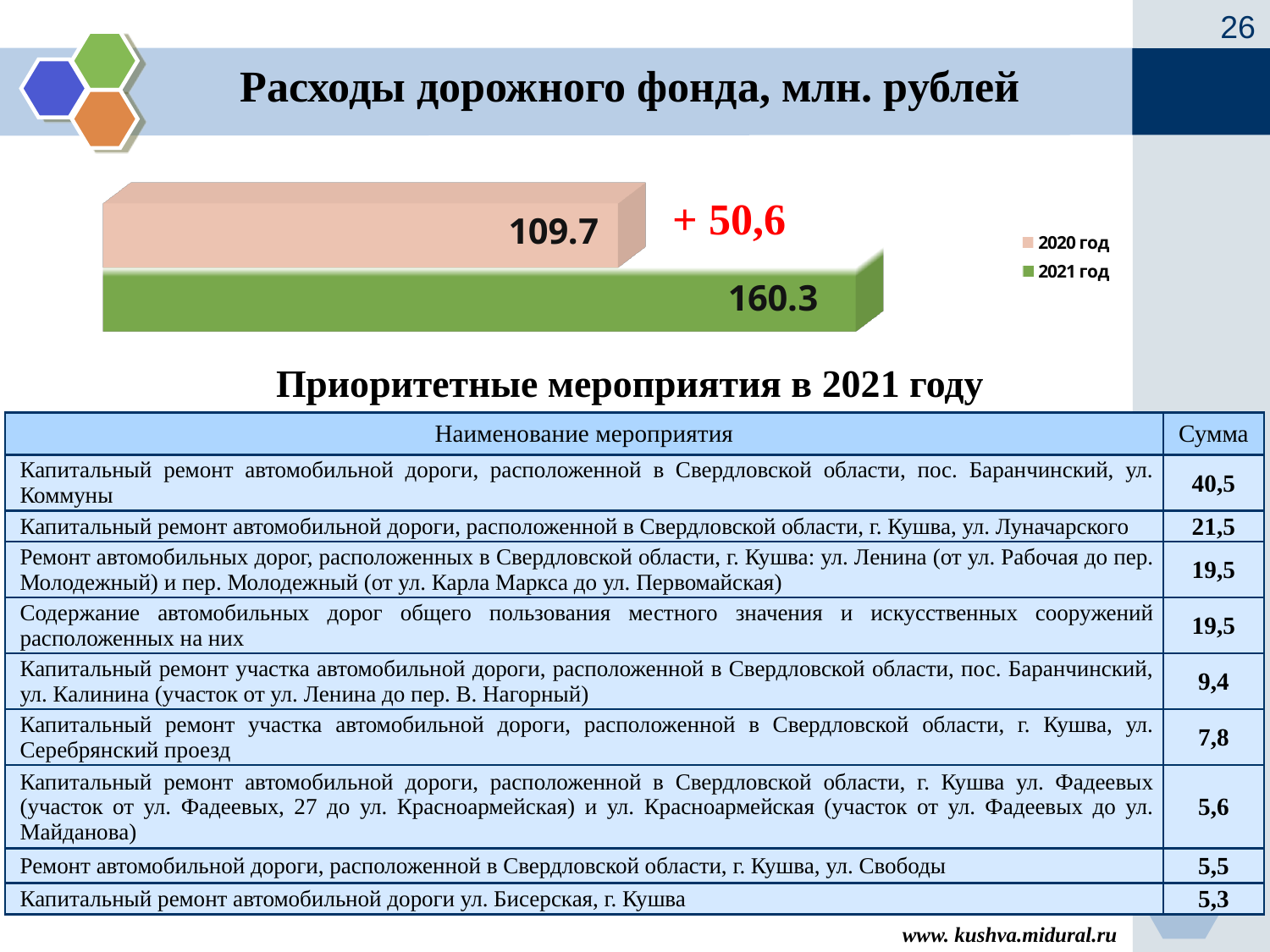
What is the value for 2021 год in the chart? 160.3 Which year has the lower road fund expenditure in the chart? 2020 год What colour is the bar for 2021 год in the chart? green Which year has the higher road fund expenditure in the chart? 2021 год How many bars are plotted in the chart? 2 What is the title of the chart on the slide? Расходы дорожного фонда, млн. рублей How many series does the chart legend list? 2 What kind of chart is shown on the slide? bar chart Which is larger: the value for 2020 год or the value for 2021 год? 2021 год What is the value for 2020 год in the chart? 109.7 Do the values rise or fall from 2020 год to 2021 год? rise By how much does the 2021 год value exceed the 2020 год value? 50.6